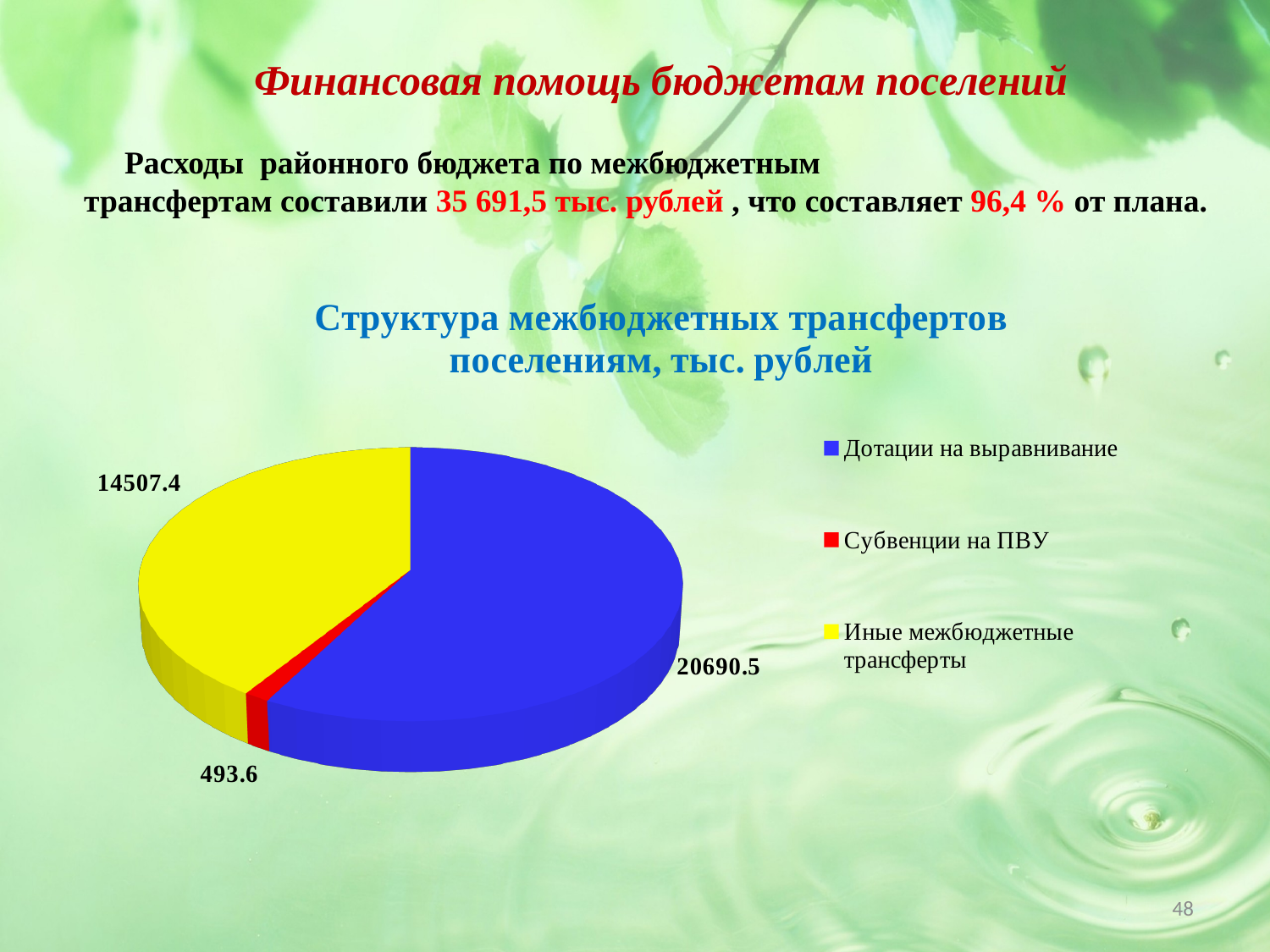
Which category has the smallest slice in the pie chart? Субвенции на ПВУ Which category has the largest slice in the pie chart? Дотации на выравнивание Which is larger: Дотации на выравнивание or Иные межбюджетные трансферты? Дотации на выравнивание How many entries does the legend of the pie chart list? 3 What is the value for Иные межбюджетные трансферты in the pie chart? 14507.4 What is the value for Субвенции на ПВУ in the pie chart? 493.6 What kind of chart is shown on the slide? Pie chart What is the difference between the values for Иные межбюджетные трансферты and Субвенции на ПВУ? 14013.8 What is the value for Дотации на выравнивание in the pie chart? 20690.5 What colour is the slice for Субвенции на ПВУ? Red What is the difference between the values for Дотации на выравнивание and Иные межбюджетные трансферты? 6183.1 How many slices does the pie chart have? 3